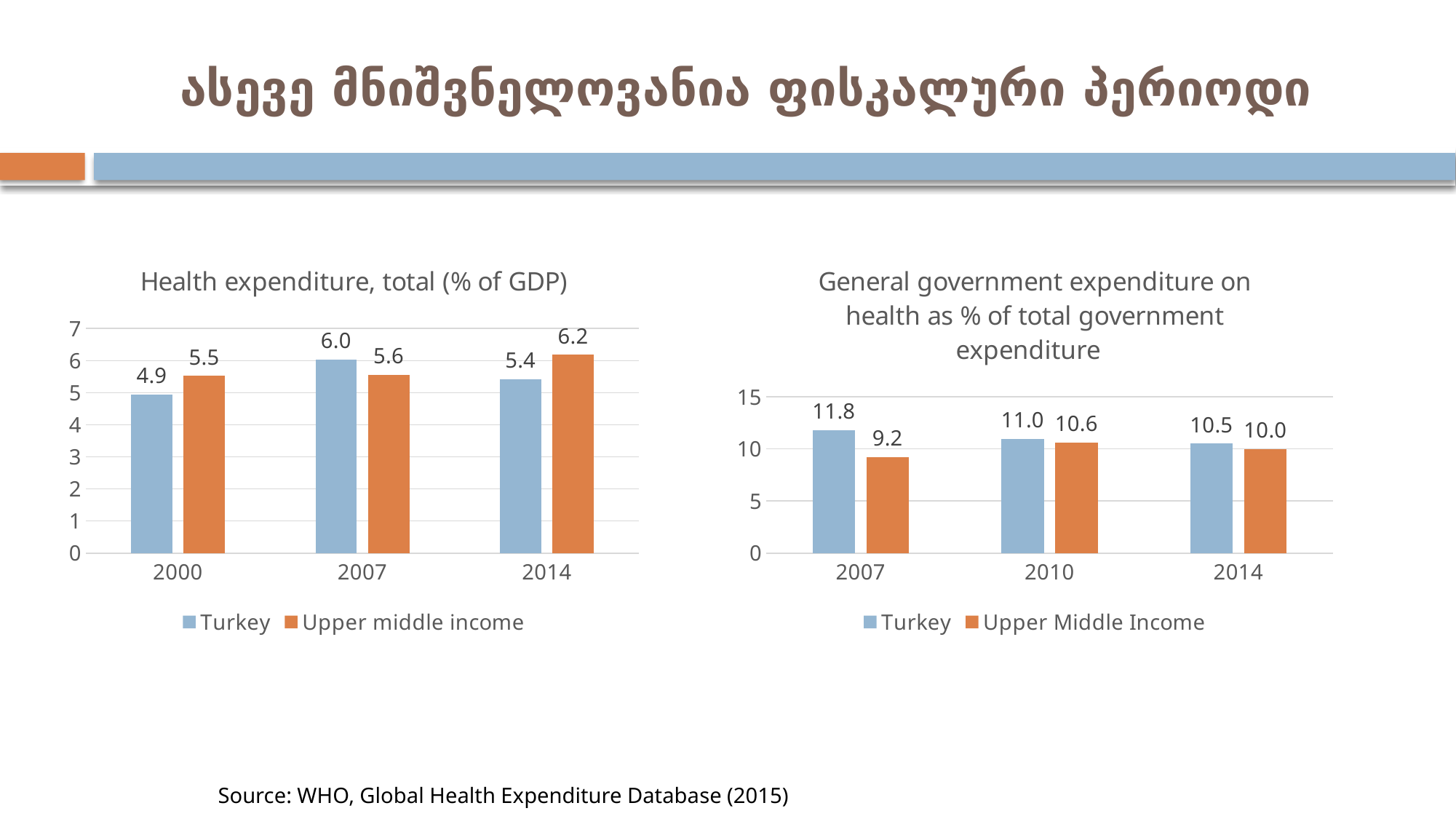
In the 'Health expenditure, total (% of GDP)' chart, in which year is Turkey's value highest? 2007 In the 'Health expenditure, total (% of GDP)' chart, which is larger in 2007: Turkey or Upper middle income? Turkey In the 'General government expenditure on health as % of total government expenditure' chart, what is the value for Upper Middle Income in 2010? 10.6 In the 'Health expenditure, total (% of GDP)' chart, how many years are shown on the x axis? 3 In the 'Health expenditure, total (% of GDP)' chart, what is the difference between Upper middle income and Turkey in 2014? 0.8 In the 'General government expenditure on health as % of total government expenditure' chart, what is the value for Turkey in 2007? 11.8 In the 'General government expenditure on health as % of total government expenditure' chart, does Turkey's value rise or fall from 2007 to 2014? fall In the 'Health expenditure, total (% of GDP)' chart, what is the value for Turkey in 2000? 4.9 In the 'General government expenditure on health as % of total government expenditure' chart, what is the difference between Turkey and Upper Middle Income in 2007? 2.6 In the 'General government expenditure on health as % of total government expenditure' chart, in which year is the Upper Middle Income value lowest? 2007 What type of chart is the 'Health expenditure, total (% of GDP)' chart? bar chart In the 'Health expenditure, total (% of GDP)' chart, what is the value for Upper middle income in 2014? 6.2